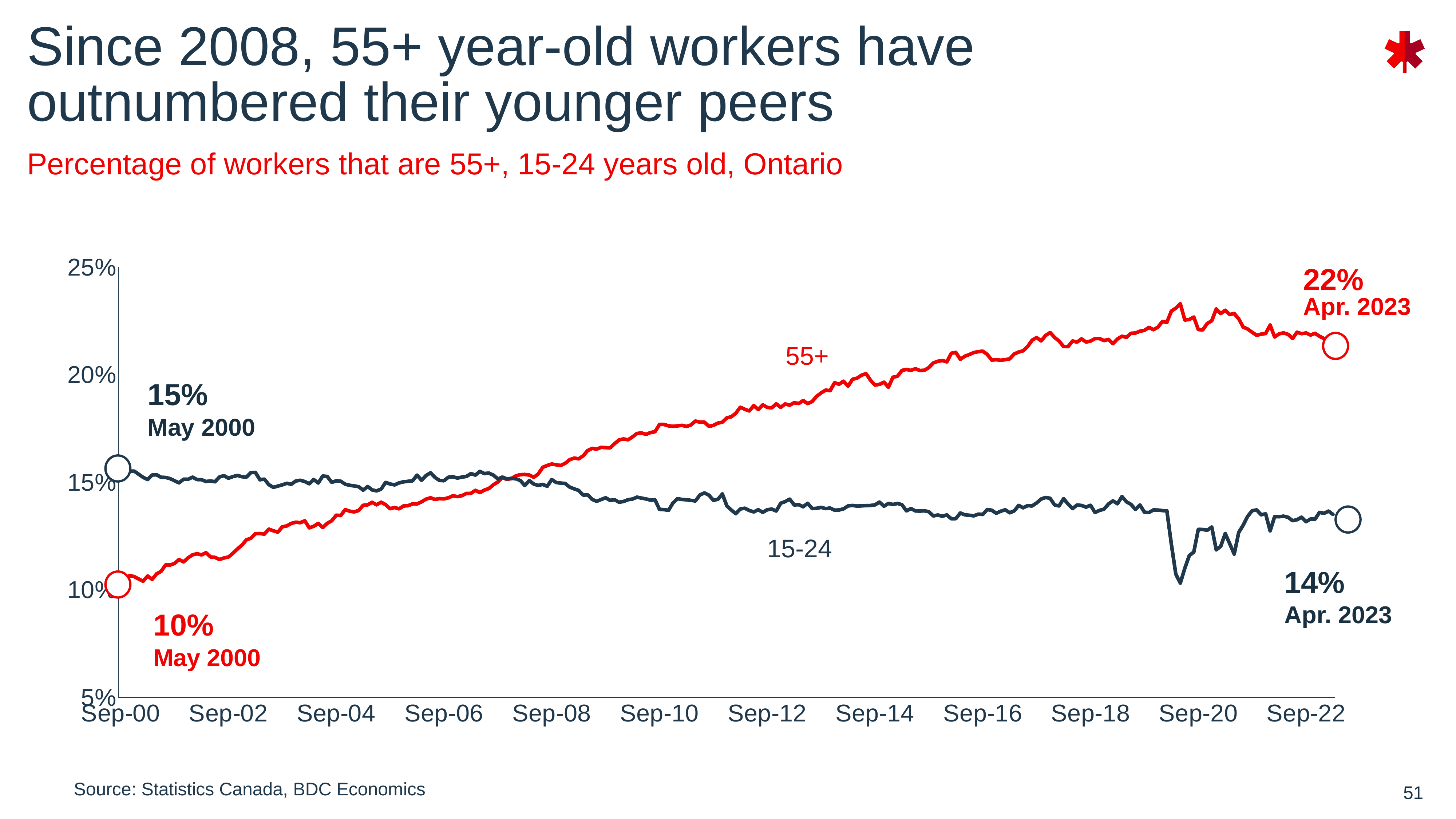
By how many percentage points did the 55+ share rise between May 2000 and Apr. 2023? 12 percentage points Does the 55+ line generally rise or fall from Sep-00 to Sep-22? rise What was the percentage of workers aged 55+ in May 2000? 10% What kind of chart is shown on the slide? line chart Is the value for the 15-24 line around Sep-20 greater or less than 15%? less In May 2000, which group had the larger share of workers, 55+ or 15-24? 15-24 By how many percentage points did the 55+ share exceed the 15-24 share in Apr. 2023? 8 percentage points What was the percentage of workers aged 55+ in Apr. 2023? 22% What was the percentage of workers aged 15-24 in May 2000? 15% In Apr. 2023, which group had the larger share of workers, 55+ or 15-24? 55+ How many lines (series) are plotted on the chart? 2 What was the percentage of workers aged 15-24 in Apr. 2023? 14%